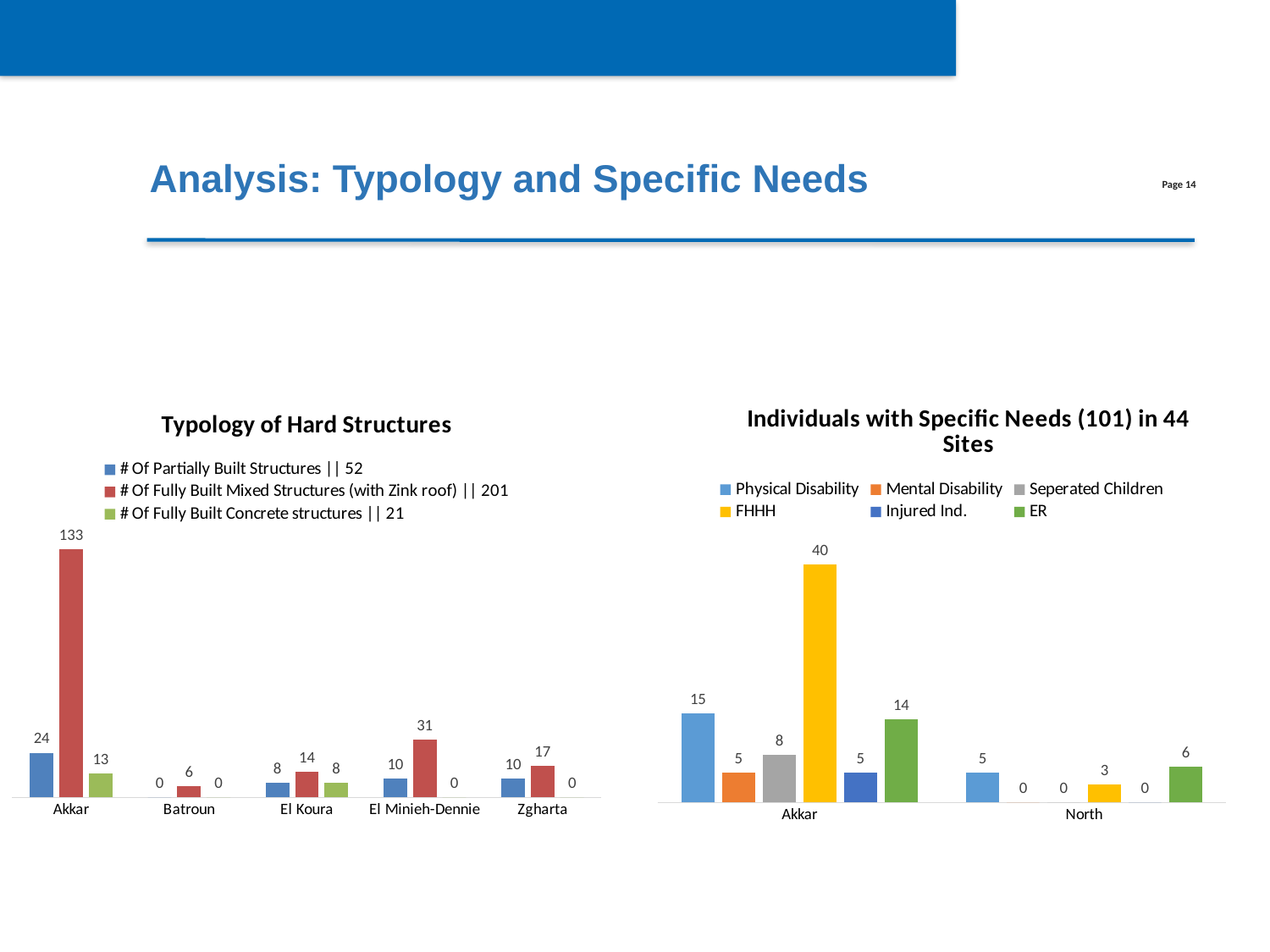
In the 'Individuals with Specific Needs (101) in 44 Sites' chart, what is the difference between the ER values for Akkar and North? 8 What type of chart is the 'Individuals with Specific Needs (101) in 44 Sites' chart? Bar chart In the 'Typology of Hard Structures' chart, how many partially built structures are there in El Minieh-Dennie? 10 In the 'Individuals with Specific Needs (101) in 44 Sites' chart, is the Physical Disability value larger in Akkar or in North? Akkar In the 'Typology of Hard Structures' chart, which district has the highest number of fully built mixed structures (with zink roof)? Akkar In the 'Typology of Hard Structures' chart, what is the difference between the fully built mixed structures in Akkar and in El Minieh-Dennie? 102 In the 'Individuals with Specific Needs (101) in 44 Sites' chart, what is the FHHH value for Akkar? 40 In the 'Typology of Hard Structures' chart, which district has the lowest number of partially built structures? Batroun In the 'Typology of Hard Structures' chart, how many districts are shown on the x axis? 5 In the 'Individuals with Specific Needs (101) in 44 Sites' chart, which category has the highest value in Akkar? FHHH In the 'Typology of Hard Structures' chart, how many series does the legend list? 3 In the 'Typology of Hard Structures' chart, how many fully built mixed structures (with zink roof) are there in Akkar? 133